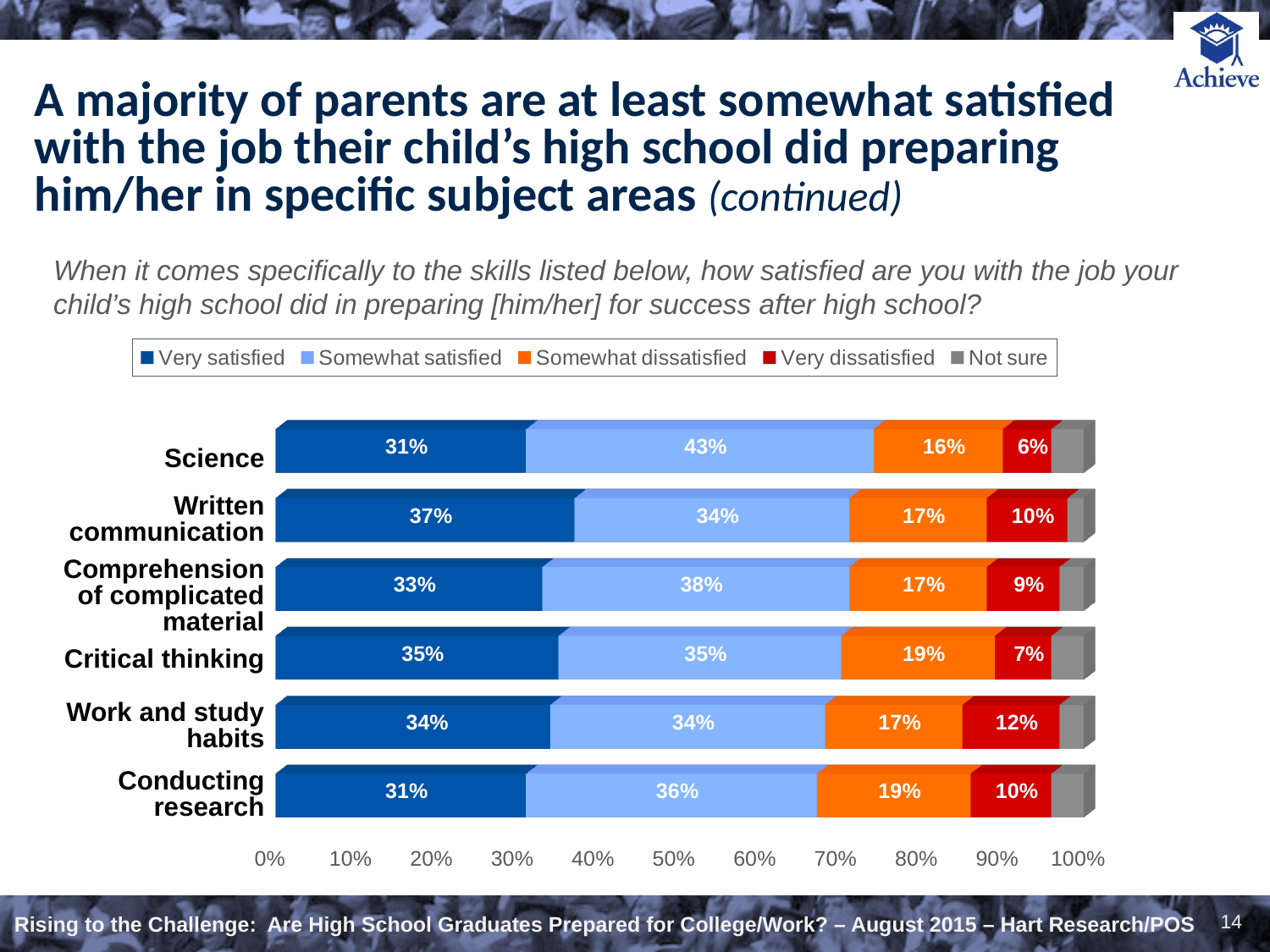
How many subject areas are shown in the chart? 6 For Science, how many percentage points higher is the somewhat satisfied share than the very satisfied share? 12 percentage points Which subject area has the lowest share of very dissatisfied parents? Science What type of chart is shown on the slide? Stacked bar chart Which subject area has the highest share of somewhat satisfied parents? Science What percentage of parents are very dissatisfied with preparation in Written communication? 10% Which subject area has the highest share of very satisfied parents? Written communication What percentage of parents are very satisfied with their child's high school preparation in Science? 31% What percentage of parents are somewhat satisfied with preparation in Conducting research? 36% What percentage of parents are somewhat dissatisfied with preparation in Critical thinking? 19% How many response categories does the legend list? 5 Which has a larger very dissatisfied share: Work and study habits or Critical thinking? Work and study habits